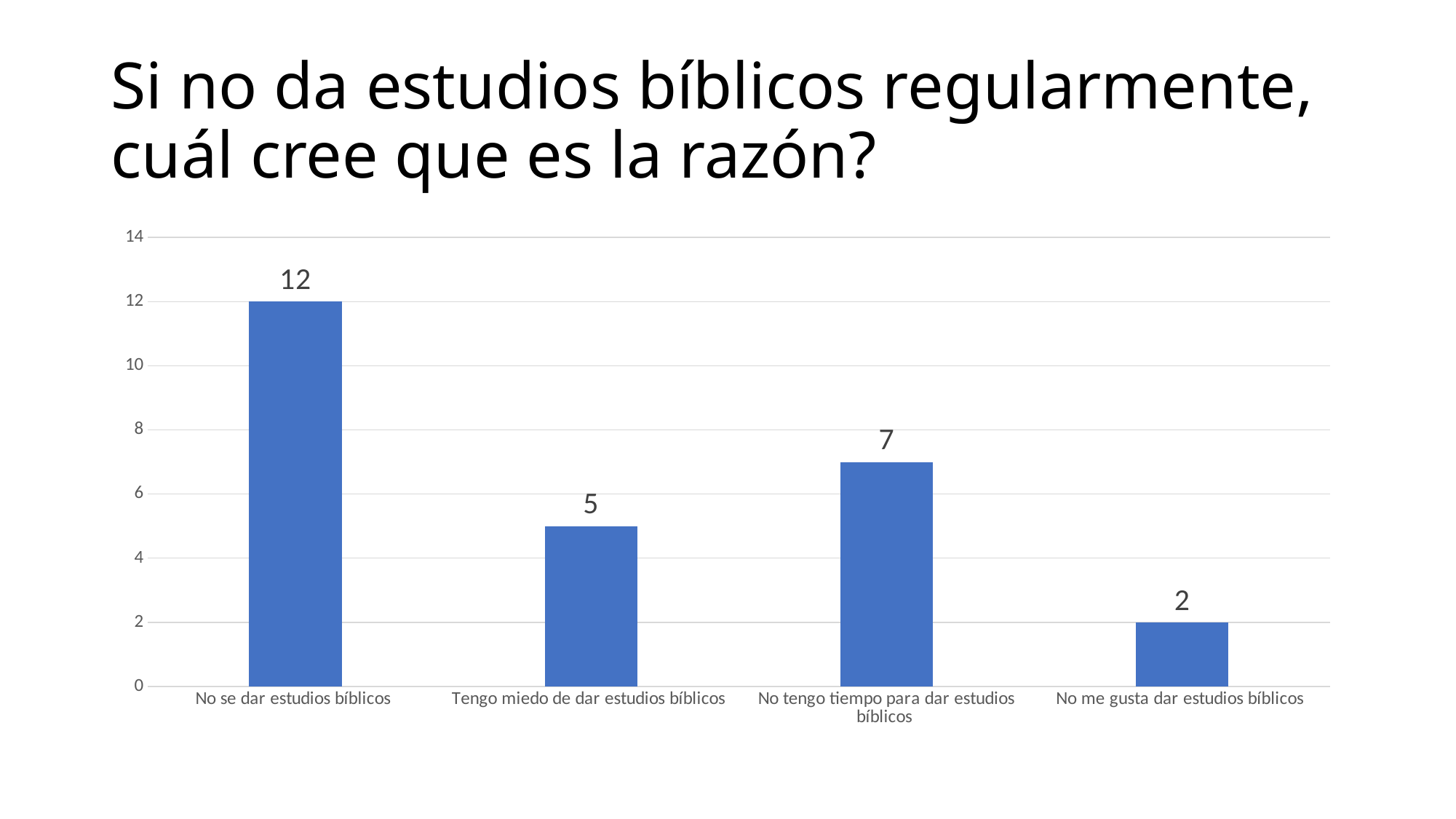
What is the value for "No se dar estudios bíblicos"? 12 Which category has the highest value? No se dar estudios bíblicos What is the title of the slide containing the chart? Si no da estudios bíblicos regularmente, cuál cree que es la razón? Which category has the lowest value? No me gusta dar estudios bíblicos What is the value for "No me gusta dar estudios bíblicos"? 2 Which is larger: the value for "Tengo miedo de dar estudios bíblicos" or the value for "No tengo tiempo para dar estudios bíblicos"? No tengo tiempo para dar estudios bíblicos What kind of chart is shown on the slide? Bar chart What is the difference between the values for "No se dar estudios bíblicos" and "No tengo tiempo para dar estudios bíblicos"? 5 How many categories are shown in the chart? 4 Is the value for "No se dar estudios bíblicos" greater or less than 10? greater What is the value for "Tengo miedo de dar estudios bíblicos"? 5 What is the value for "No tengo tiempo para dar estudios bíblicos"? 7